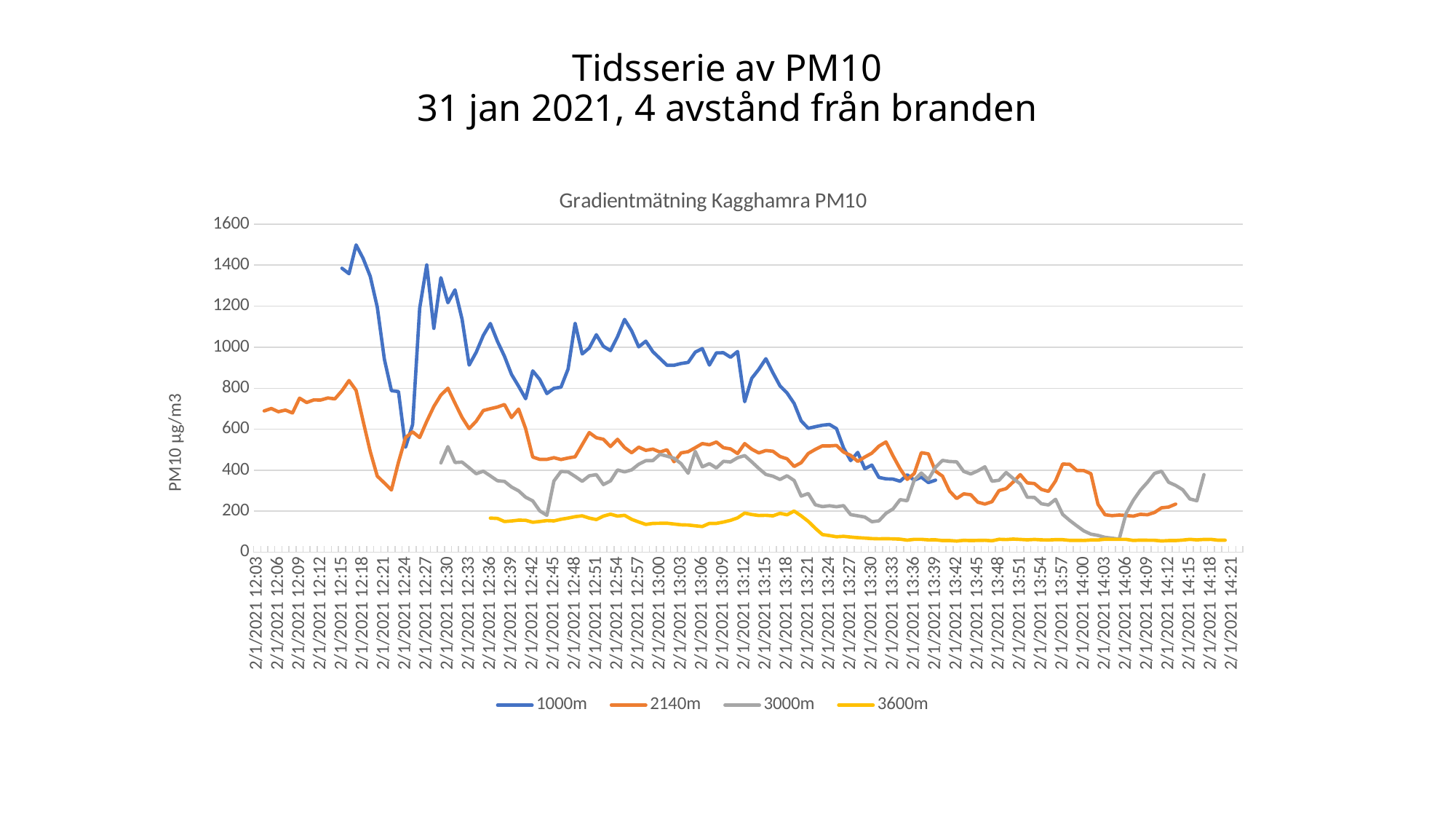
How many series does the legend list? 4 What is the label on the vertical axis? PM10 µg/m3 What is the title of the chart? Gradientmätning Kagghamra PM10 What kind of chart is shown on the slide? line chart Is the value for the 3600m series at 2/1/2021 13:24 greater or less than 200? less Is the peak value of the 1000m series greater or less than 1400? greater Which series stays lowest across the chart? 3600m At 2/1/2021 12:15, which series has the larger value, 1000m or 2140m? 1000m Is the value for the 2140m series at 2/1/2021 12:21 greater or less than 400? less Does the 1000m series generally rise or fall from 2/1/2021 12:15 to 2/1/2021 13:39? fall Which series reaches the highest value on the chart? 1000m